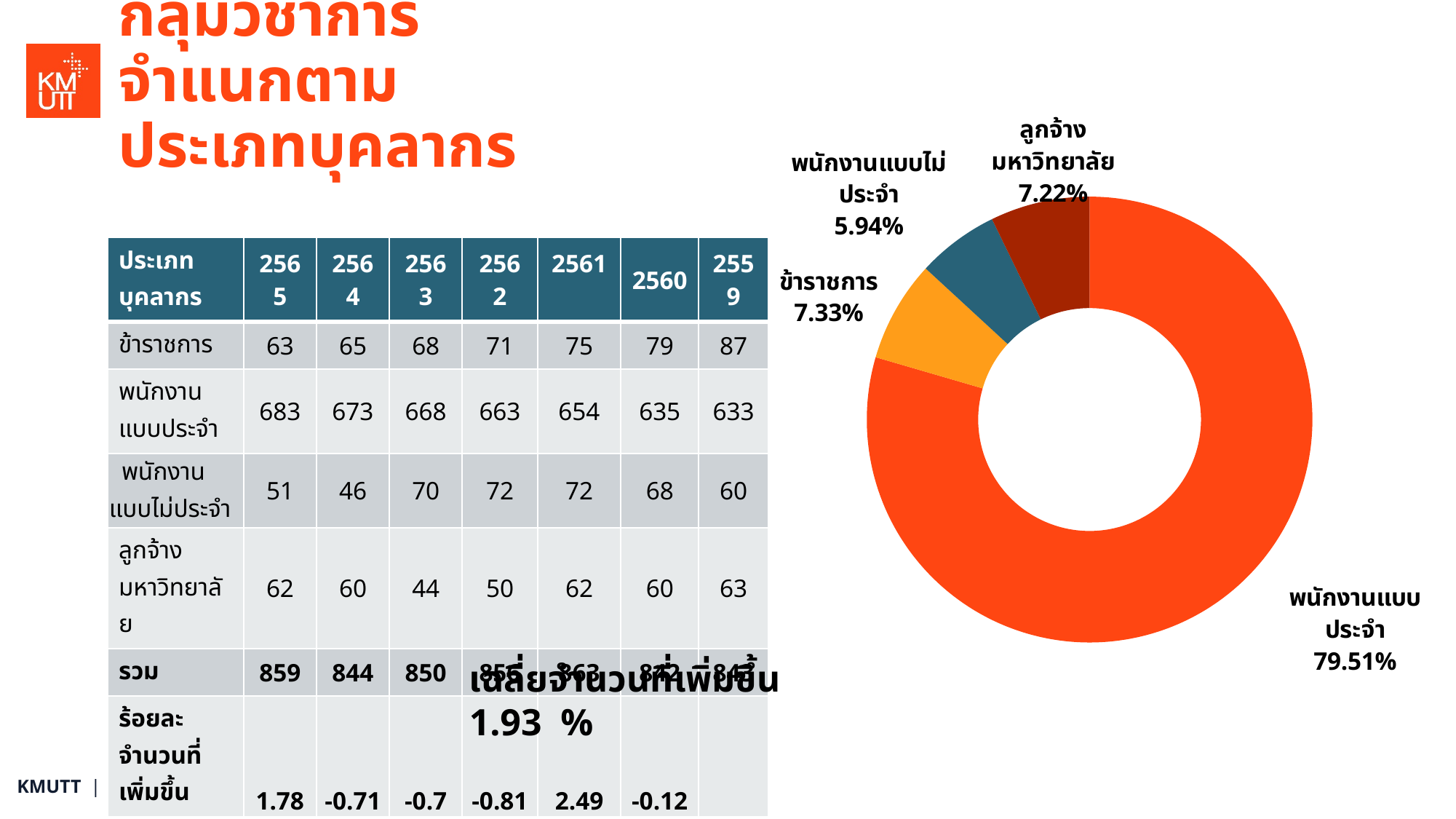
What colour is the largest slice of the donut chart? Orange-red What percentage is shown for ข้าราชการ in the donut chart? 7.33% How many slices does the donut chart have? 4 What share of the donut chart is พนักงานแบบประจำ? 79.51% In the donut chart, what is the difference in percentage points between ข้าราชการ and ลูกจ้างมหาวิทยาลัย? 0.11 Which category has the largest slice in the donut chart? พนักงานแบบประจำ In the donut chart, which is larger: ข้าราชการ or พนักงานแบบไม่ประจำ? ข้าราชการ In the donut chart, what is the difference in percentage points between พนักงานแบบประจำ and ข้าราชการ? 72.18 What percentage is shown for พนักงานแบบไม่ประจำ in the donut chart? 5.94% Which category has the smallest slice in the donut chart? พนักงานแบบไม่ประจำ What percentage is shown for ลูกจ้างมหาวิทยาลัย in the donut chart? 7.22% What kind of chart is shown on the right side of the slide? Pie (donut) chart